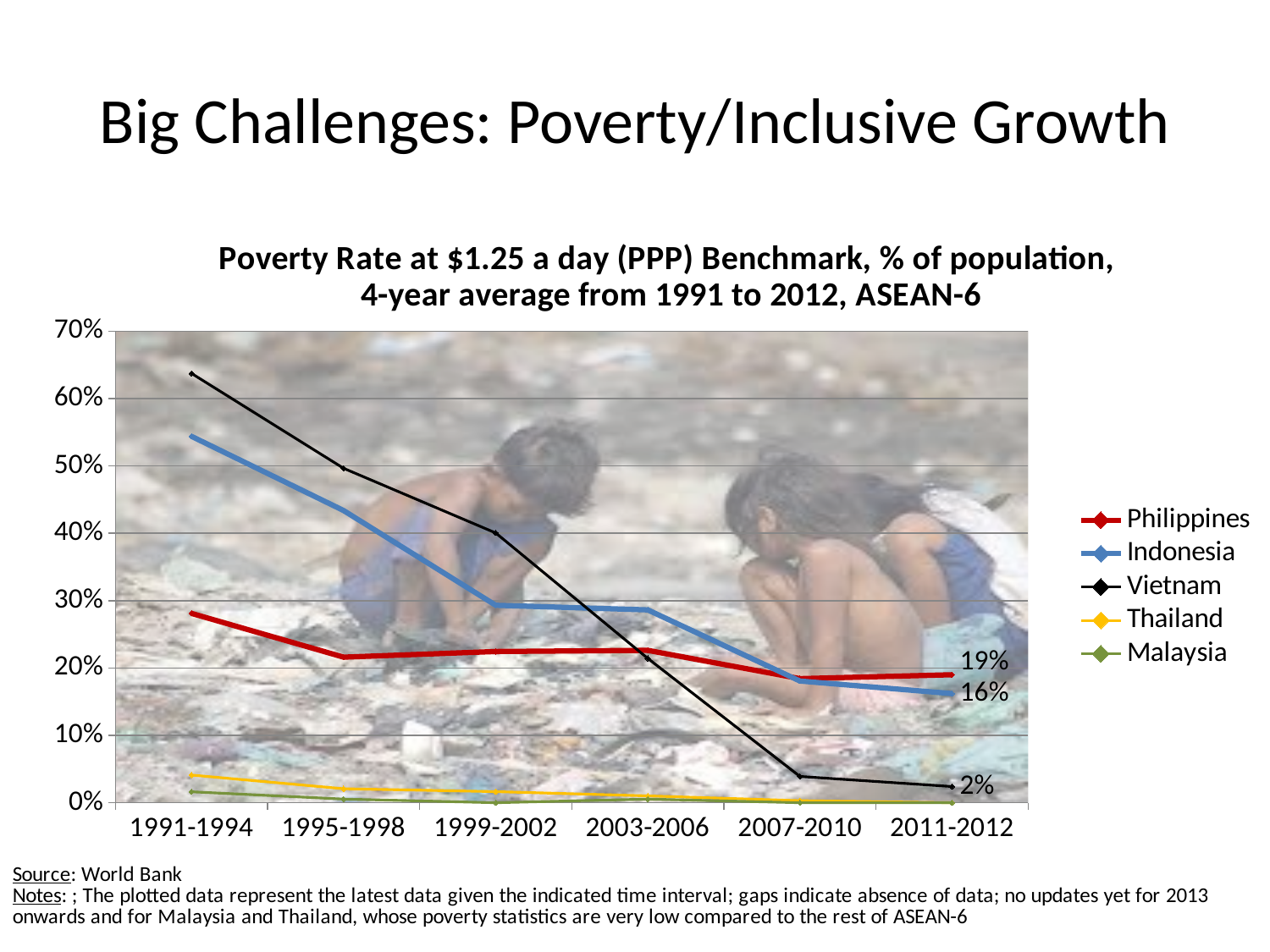
Is the poverty rate for the Philippines in 1991-1994 greater or less than 30%? less What is the poverty rate for Indonesia in 2011-2012? 16% Is the poverty rate for Vietnam in 1991-1994 greater or less than 60%? greater Which country has the highest poverty rate in 1991-1994? Vietnam How many time periods are shown on the x axis? 6 What is the poverty rate for the Philippines in 2011-2012? 19% Is the poverty rate for Vietnam in 2007-2010 greater or less than 10%? less How many countries are listed in the legend? 5 In 2011-2012, which has the higher poverty rate, the Philippines or Indonesia? Philippines What kind of chart is shown on the slide? Line chart What is the poverty rate for Vietnam in 2011-2012? 2% What is the difference between the Philippines and Indonesia poverty rates in 2011-2012? 3 percentage points